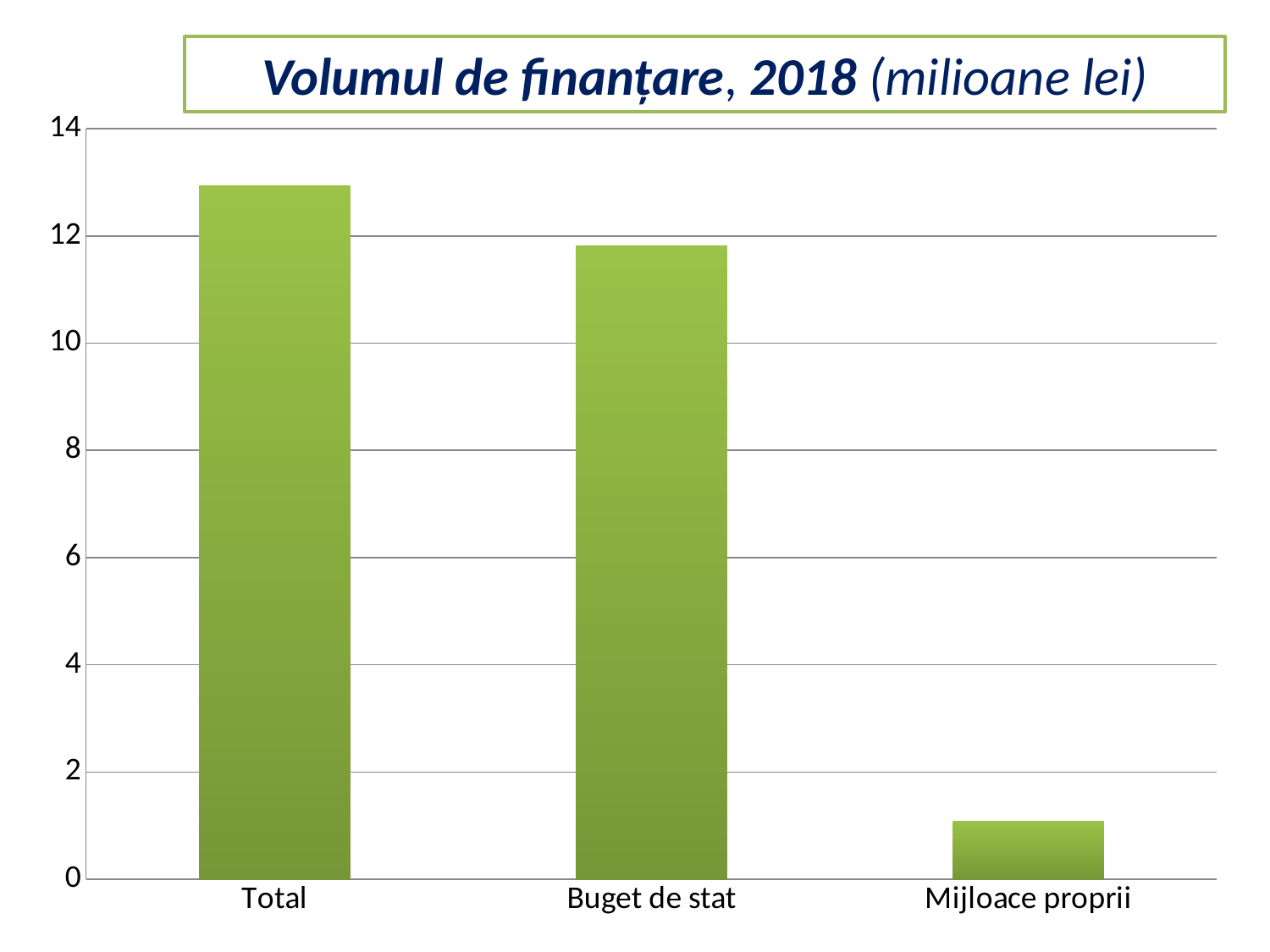
Which is larger, the value for Total or the value for Buget de stat? Total Which is larger, the value for Buget de stat or the value for Mijloace proprii? Buget de stat What is the title of the chart? Volumul de finanțare, 2018 (milioane lei) Is the value for Buget de stat greater or less than 12? less Which category has the lowest value? Mijloace proprii Which category has the highest value? Total Is the value for Mijloace proprii greater or less than 2? less Is the value for Buget de stat greater or less than 10? greater How many categories are shown on the x axis? 3 What is the highest value shown on the y axis? 14 What kind of chart is shown on the slide? bar chart